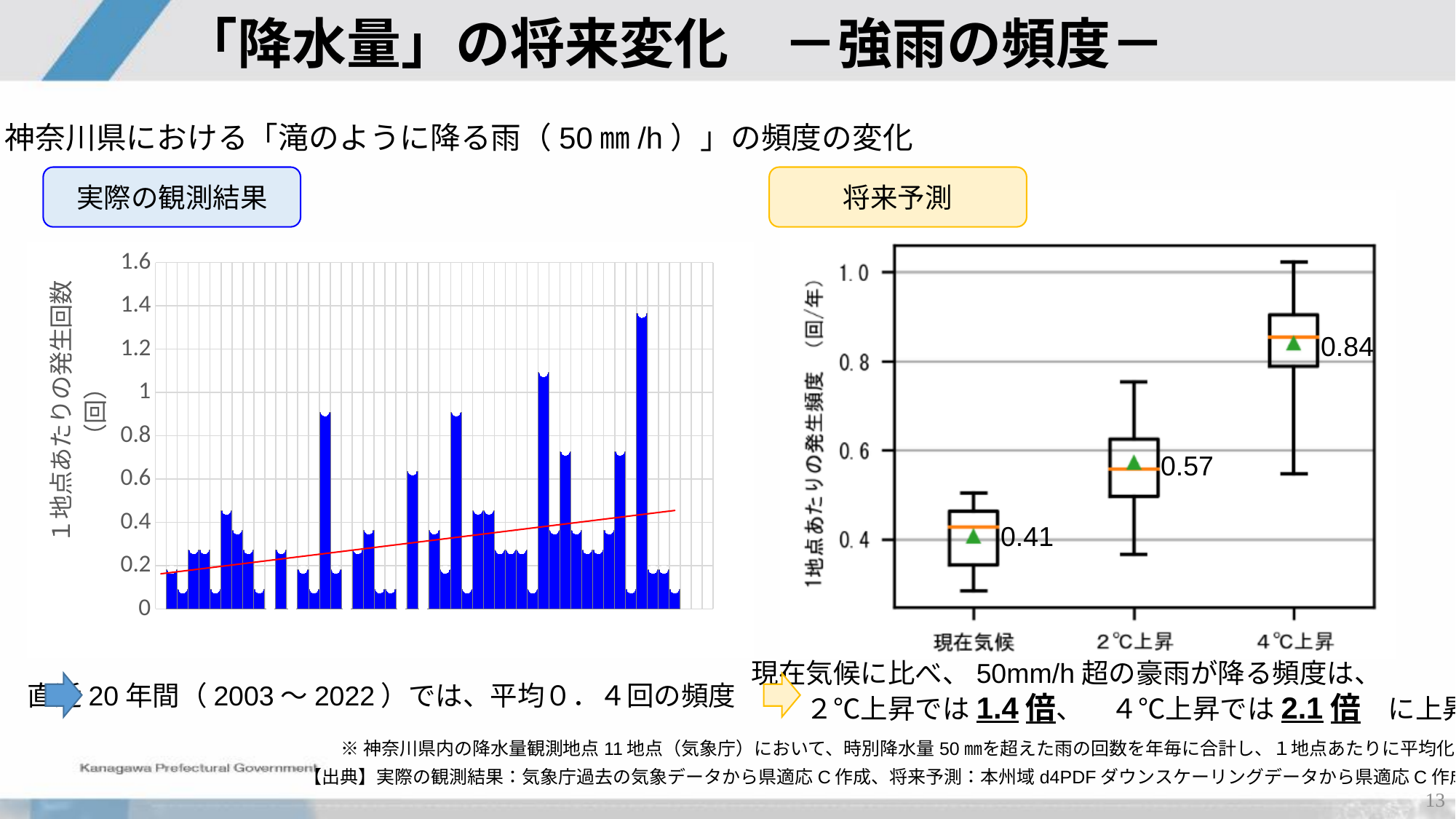
In the right chart (将来予測), which category has the lowest labelled value? 現在気候 In the right chart (将来予測), which is larger, the labelled value for 2℃上昇 or for 現在気候? 2℃上昇 In the right chart (将来予測), what is the labelled value for 4℃上昇? 0.84 In the right chart (将来予測), which category has the highest labelled value? 4℃上昇 In the right chart (将来予測), what is the labelled value for 現在気候? 0.41 In the right chart (将来予測), what is the difference between the labelled values for 4℃上昇 and 現在気候? 0.43 In the right chart (将来予測), what is the labelled value for 2℃上昇? 0.57 What kind of chart is the left chart (実際の観測結果)? bar chart In the right chart (将来予測), do the labelled values rise or fall from 現在気候 to 4℃上昇? rise In the right chart (将来予測), what is the difference between the labelled values for 4℃上昇 and 2℃上昇? 0.27 In the left chart (実際の観測結果), is the tallest bar greater or less than 1.2? greater How many categories are shown on the x axis of the right chart (将来予測)? 3